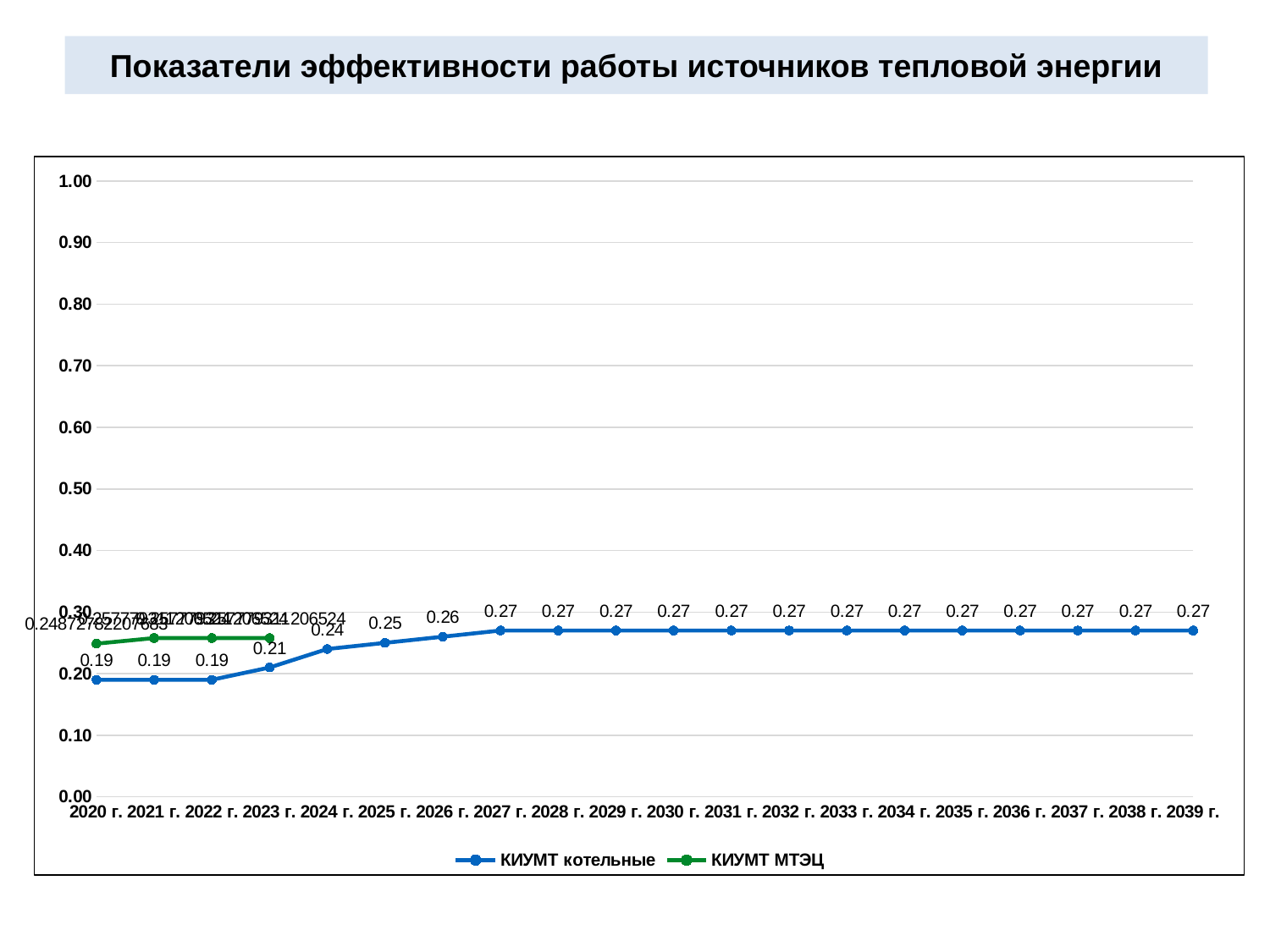
How many years are shown on the x axis? 20 What is the value of КИУМТ котельные in 2023 г.? 0.21 What colour is the line for КИУМТ МТЭЦ? green Is the value for КИУМТ котельные in 2030 г. greater or less than 0.50? less Does the КИУМТ котельные series rise or fall from 2020 г. to 2027 г.? rise What is the value of КИУМТ котельные in 2020 г.? 0.19 Which is larger for КИУМТ котельные: the value in 2024 г. or the value in 2026 г.? 2026 г. What type of chart is shown on the slide? line chart What is the value of КИУМТ котельные in 2025 г.? 0.25 What is the value of КИУМТ котельные in 2039 г.? 0.27 What is the difference between the КИУМТ котельные values in 2027 г. and 2020 г.? 0.08 How many series does the legend list? 2